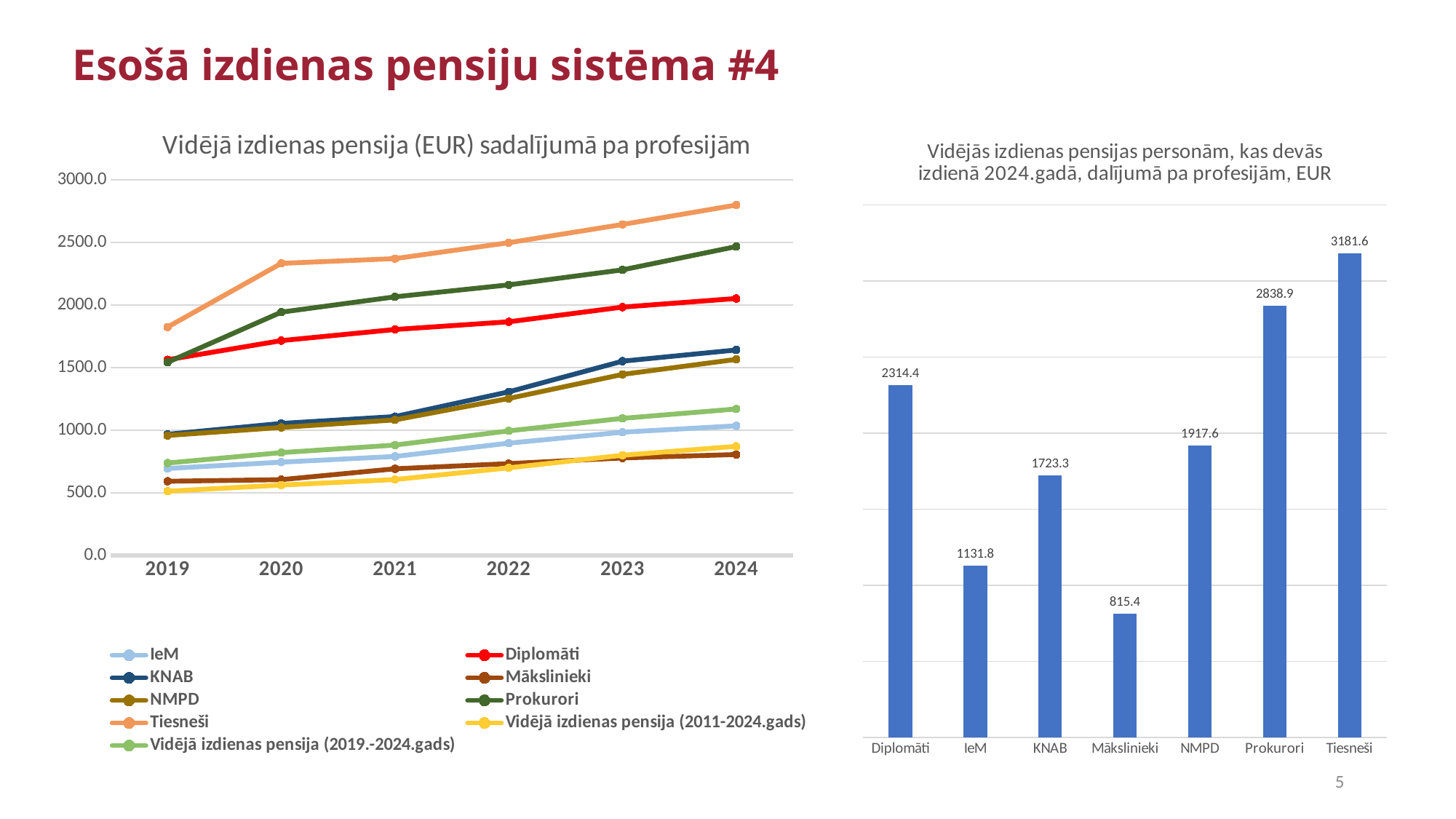
In the left chart, is the value for Tiesneši in 2024 greater or less than 2500? greater In the right chart, what is the value for Mākslinieki? 815.4 In the left chart, does the Tiesneši line rise or fall from 2019 to 2024? rise In the right chart, which profession has the lowest value? Mākslinieki How many professions are shown in the right chart? 7 What kind of chart is the right chart? Bar chart In the right chart (Vidējās izdienas pensijas personām, kas devās izdienā 2024.gadā), what is the value for Prokurori? 2838.9 In the left chart, is the value for Mākslinieki in 2024 greater or less than 1000? less In the right chart, which profession has the highest value? Tiesneši How many series does the legend of the left chart (Vidējā izdienas pensija (EUR) sadalījumā pa profesijām) list? 9 In the right chart, what is the difference between the values for Tiesneši and Diplomāti? 867.2 In the right chart, which is larger: the value for KNAB or the value for NMPD? NMPD